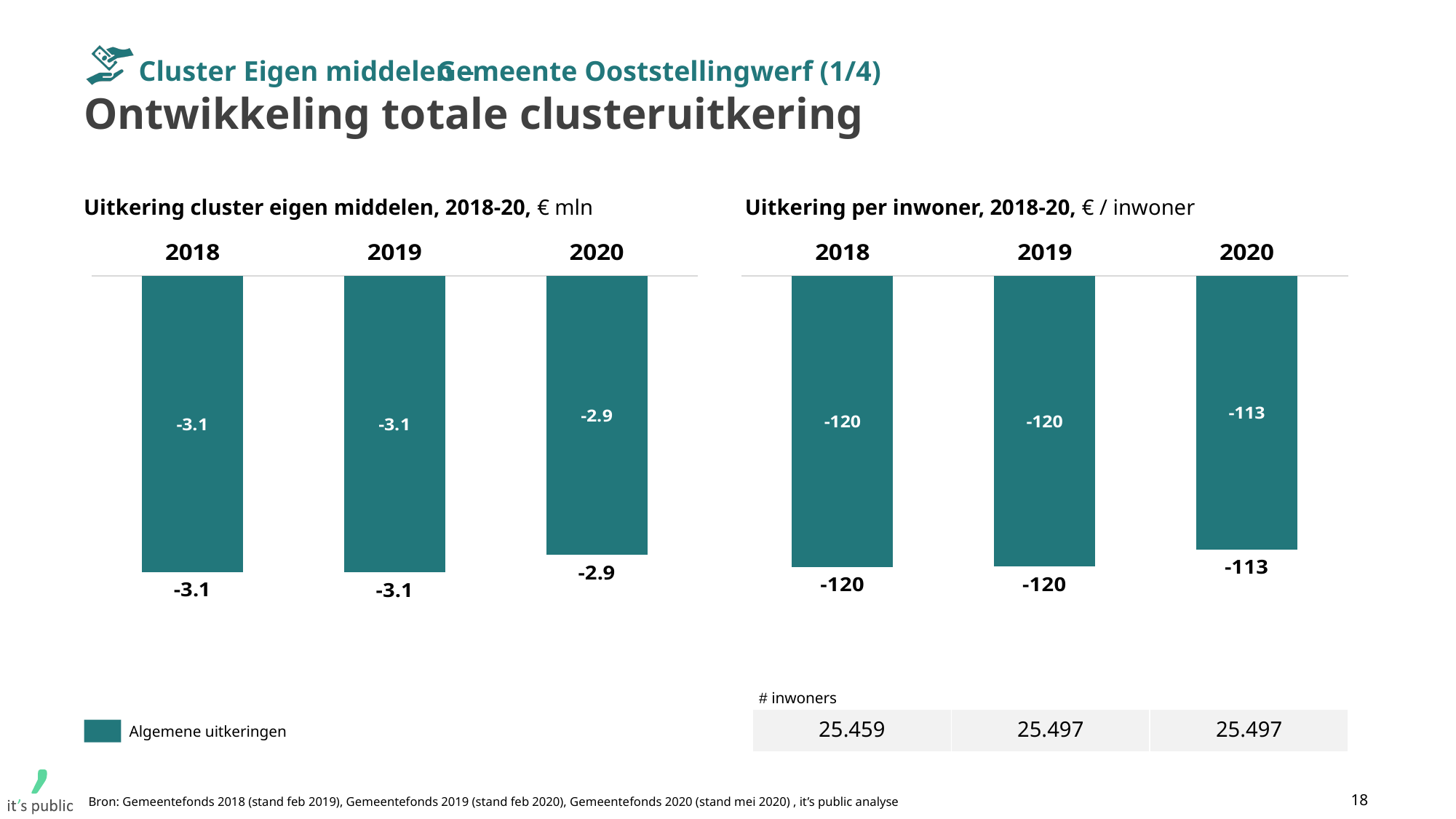
What type of chart is 'Uitkering cluster eigen middelen, 2018-20'? bar chart In the chart 'Uitkering per inwoner, 2018-20', what is the value for 2019? -120 In the chart 'Uitkering per inwoner, 2018-20', what is the value for 2020? -113 In the chart 'Uitkering cluster eigen middelen, 2018-20', what is the difference between the 2019 value and the 2020 value? 0.2 In the chart 'Uitkering cluster eigen middelen, 2018-20', what is the value for 2020? -2.9 In the chart 'Uitkering cluster eigen middelen, 2018-20', is the value for 2020 higher or lower than the value for 2019? higher What is the legend entry shown below the left chart? Algemene uitkeringen In the chart 'Uitkering cluster eigen middelen, 2018-20', what is the value for 2018? -3.1 In the chart 'Uitkering per inwoner, 2018-20', what is the difference between the 2018 value and the 2020 value? 7 How many years are shown in the chart 'Uitkering per inwoner, 2018-20'? 3 In the '# inwoners' table under the right chart, what is the number of inhabitants for 2018? 25.459 In the chart 'Uitkering per inwoner, 2018-20', which year has the highest (least negative) value? 2020